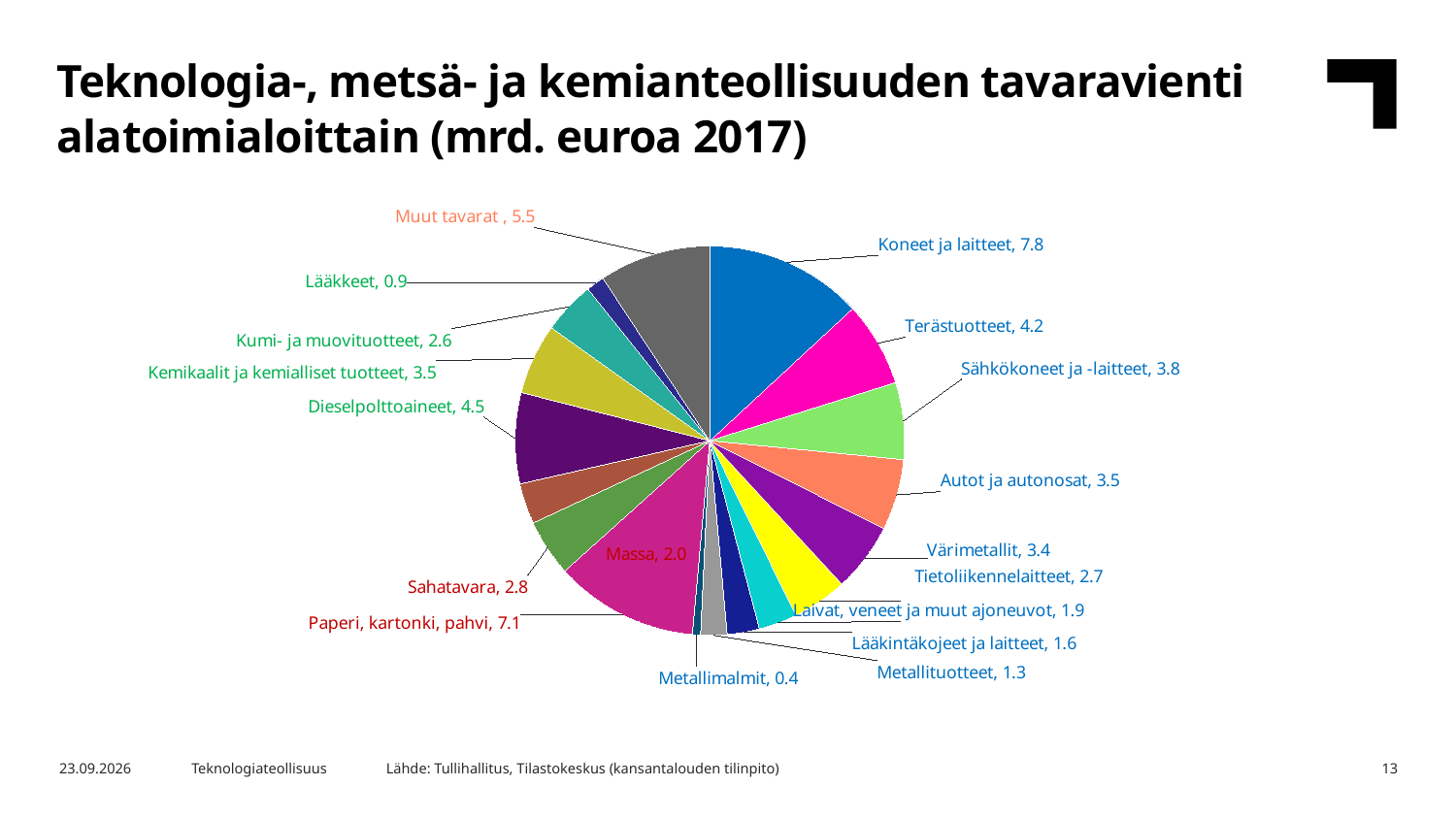
How many categories (slices) does the pie chart have? 18 Which is larger, the value for Terästuotteet or the value for Dieselpolttoaineet? Dieselpolttoaineet Which category has the largest value in the pie chart? Koneet ja laitteet What type of chart is shown on the slide? Pie chart What is the title of the slide? Teknologia-, metsä- ja kemianteollisuuden tavaravienti alatoimialoittain (mrd. euroa 2017) What is the value for Paperi, kartonki, pahvi? 7.1 What is the value for Dieselpolttoaineet? 4.5 What is the value for Metallimalmit? 0.4 What is the value for Lääkkeet? 0.9 What is the value for Koneet ja laitteet? 7.8 What is the difference between the values for Koneet ja laitteet and Paperi, kartonki, pahvi? 0.7 Which category has the smallest value in the pie chart? Metallimalmit